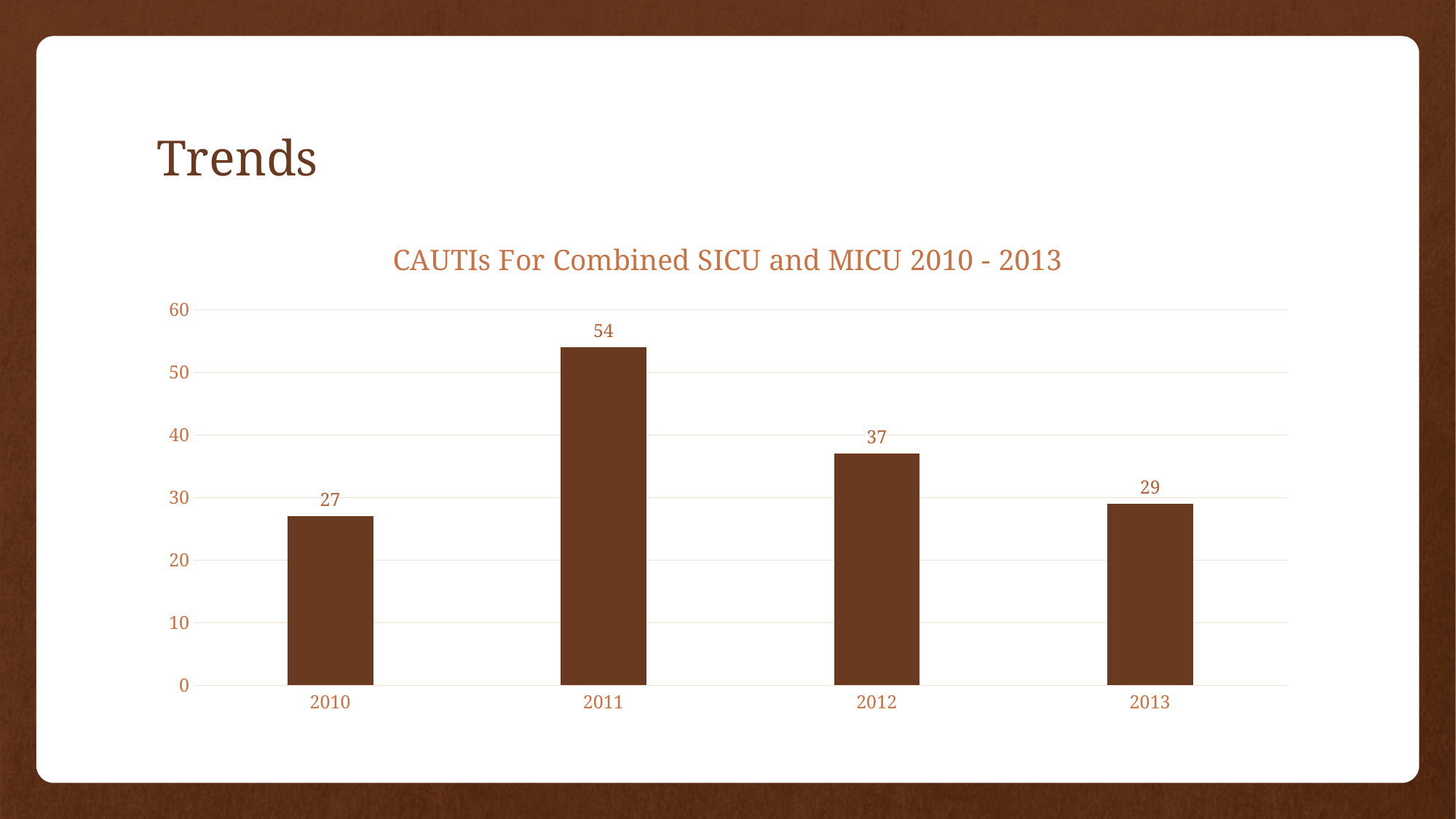
How many years are shown on the x axis? 4 What is the value for 2010? 27 Which year has the highest value? 2011 What is the value for 2011? 54 What is the value for 2013? 29 What is the difference between the values for 2011 and 2012? 17 What is the difference between the values for 2013 and 2010? 2 Is the value for 2012 greater or less than 40? less Which year has the lowest value? 2010 What kind of chart is shown on the slide? bar chart What is the title of the chart? CAUTIs For Combined SICU and MICU 2010 - 2013 Which is larger, the value for 2012 or the value for 2013? 2012